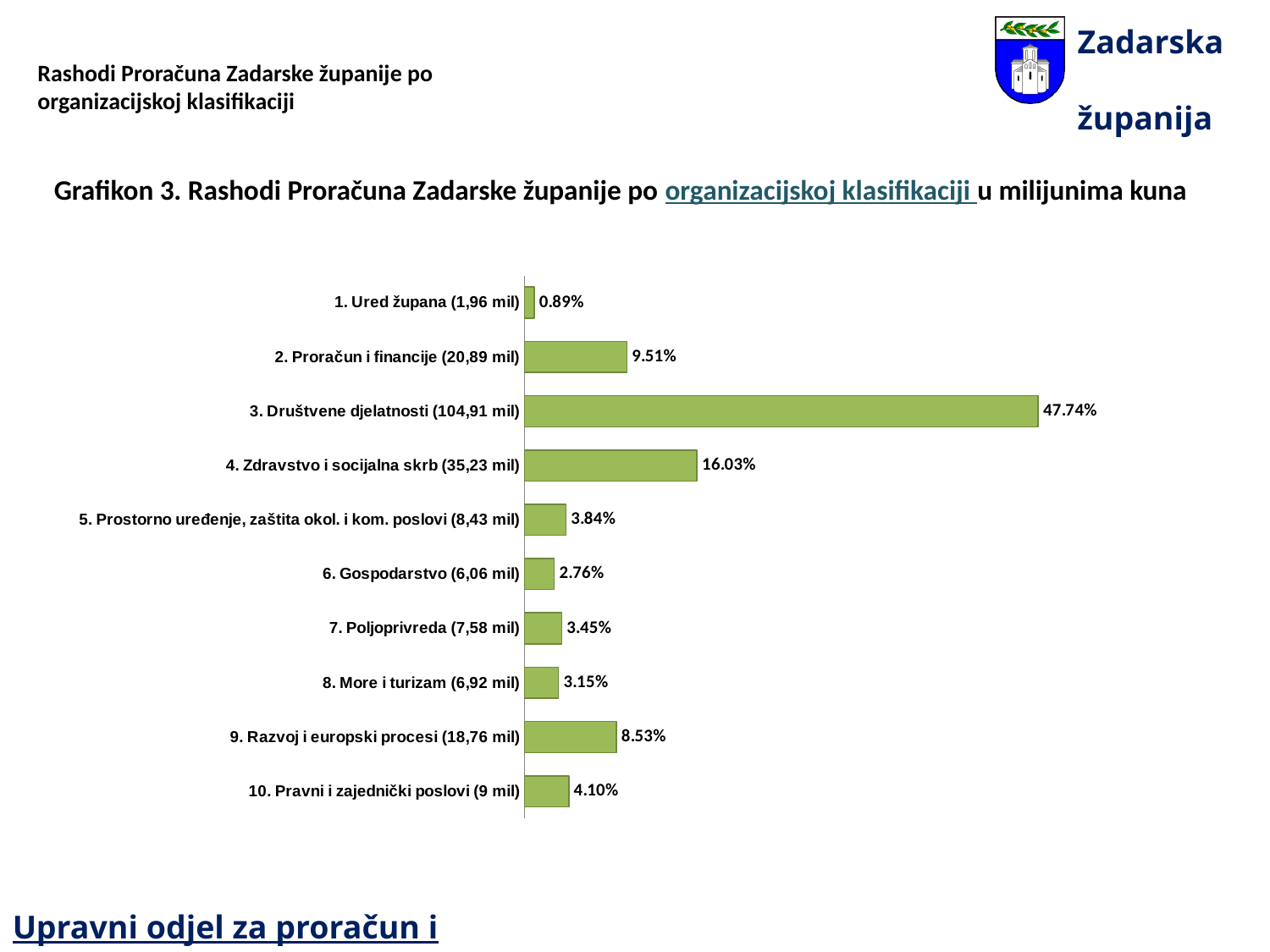
What is the difference in percentage points between 4. Zdravstvo i socijalna skrb and 2. Proračun i financije? 6.52 What is the title of the chart? Grafikon 3. Rashodi Proračuna Zadarske županije po organizacijskoj klasifikaciji u milijunima kuna What kind of chart is this? Bar chart Which category has the lowest percentage? 1. Ured župana (1,96 mil) How many categories are shown in the chart? 10 What percentage is shown for 3. Društvene djelatnosti (104,91 mil)? 47.74% What colour are the bars in the chart? Green What percentage is shown for 6. Gospodarstvo (6,06 mil)? 2.76% Which category has the highest percentage? 3. Društvene djelatnosti (104,91 mil) Which has a larger percentage, 10. Pravni i zajednički poslovi or 5. Prostorno uređenje, zaštita okol. i kom. poslovi? 10. Pravni i zajednički poslovi What percentage is shown for 9. Razvoj i europski procesi (18,76 mil)? 8.53% Which has a larger percentage, 7. Poljoprivreda or 8. More i turizam? 7. Poljoprivreda